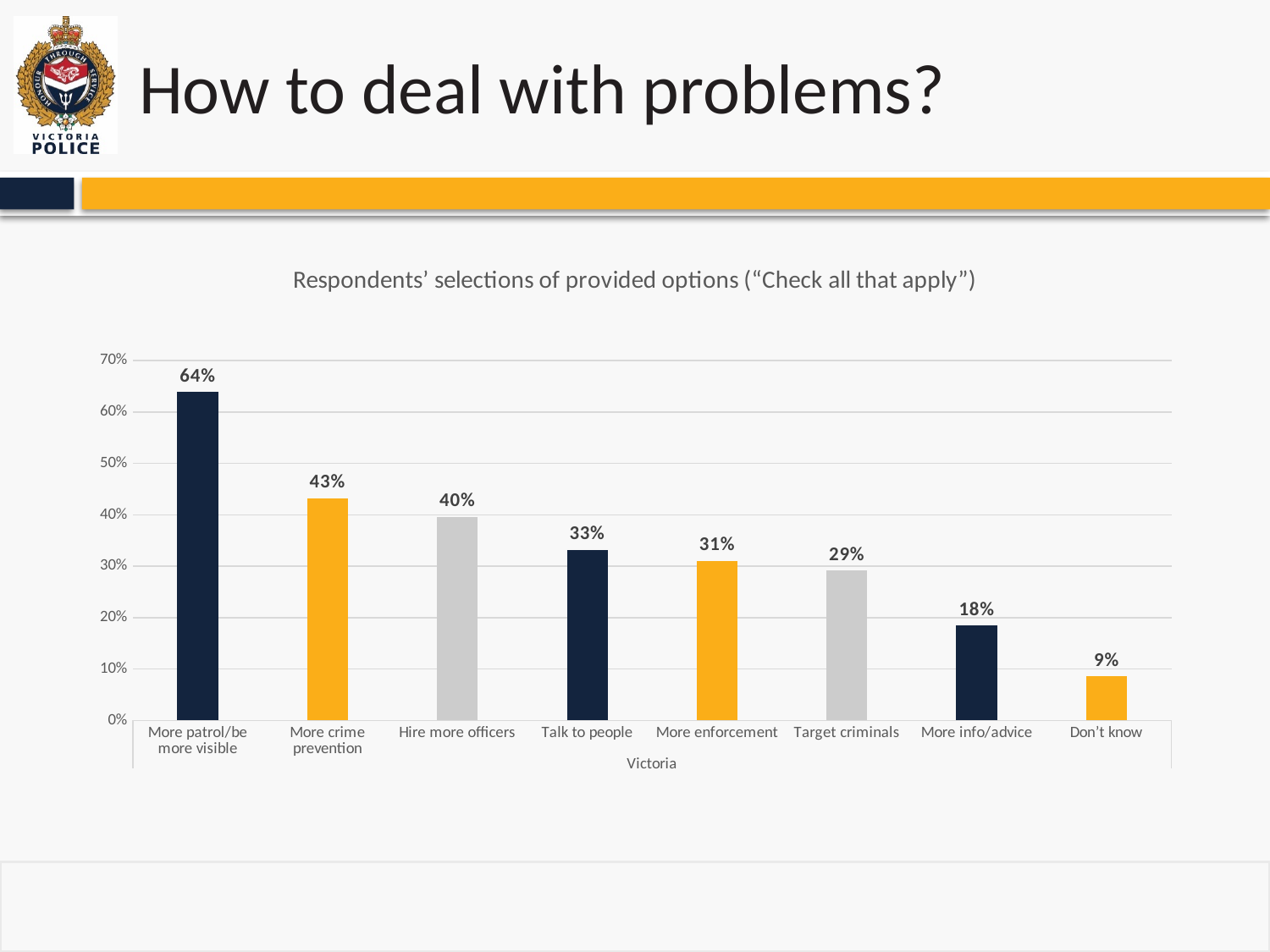
Is the value for "Hire more officers" greater or less than 30%? greater Which option has the lowest percentage of respondents? Don't know What is the difference in percentage points between "More patrol/be more visible" and "More info/advice"? 46 What is the difference in percentage points between "More crime prevention" and "Hire more officers"? 3 What is the title of the chart? Respondents' selections of provided options ("Check all that apply") Which option has the highest percentage of respondents? More patrol/be more visible What kind of chart is shown on the slide? Bar chart What percentage is shown for "Don't know"? 9% What is the value shown for "Target criminals"? 29% Which has a higher value, "Talk to people" or "More enforcement"? Talk to people What percentage of respondents selected "More patrol/be more visible"? 64% How many options are shown on the x axis of the chart? 8